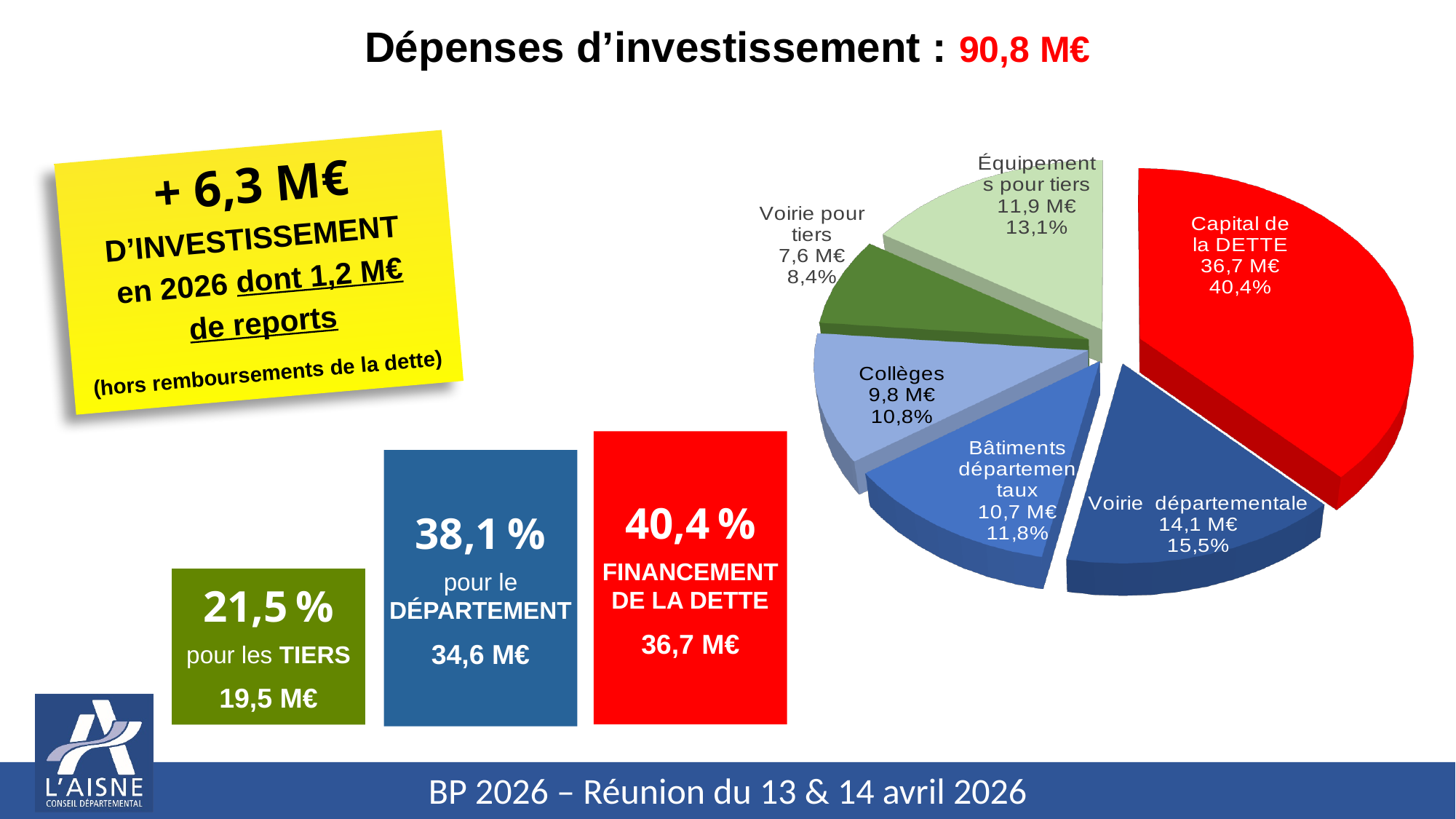
What is the value for Collèges in the pie chart? 9,8 M€ How many slices does the pie chart have? 6 What share of the pie does Voirie pour tiers represent? 8,4% What type of chart is shown on the slide? pie chart What is the value for Capital de la DETTE in the pie chart? 36,7 M€ What share of the pie does Bâtiments départementaux represent? 11,8% Which slice of the pie chart is the smallest? Voirie pour tiers What is the value for Équipements pour tiers in the pie chart? 11,9 M€ What is the value for Voirie départementale in the pie chart? 14,1 M€ Which is larger in the pie chart, Collèges or Bâtiments départementaux? Bâtiments départementaux What is the difference between Capital de la DETTE and Voirie départementale in the pie chart? 22,6 M€ Which slice of the pie chart is the largest? Capital de la DETTE